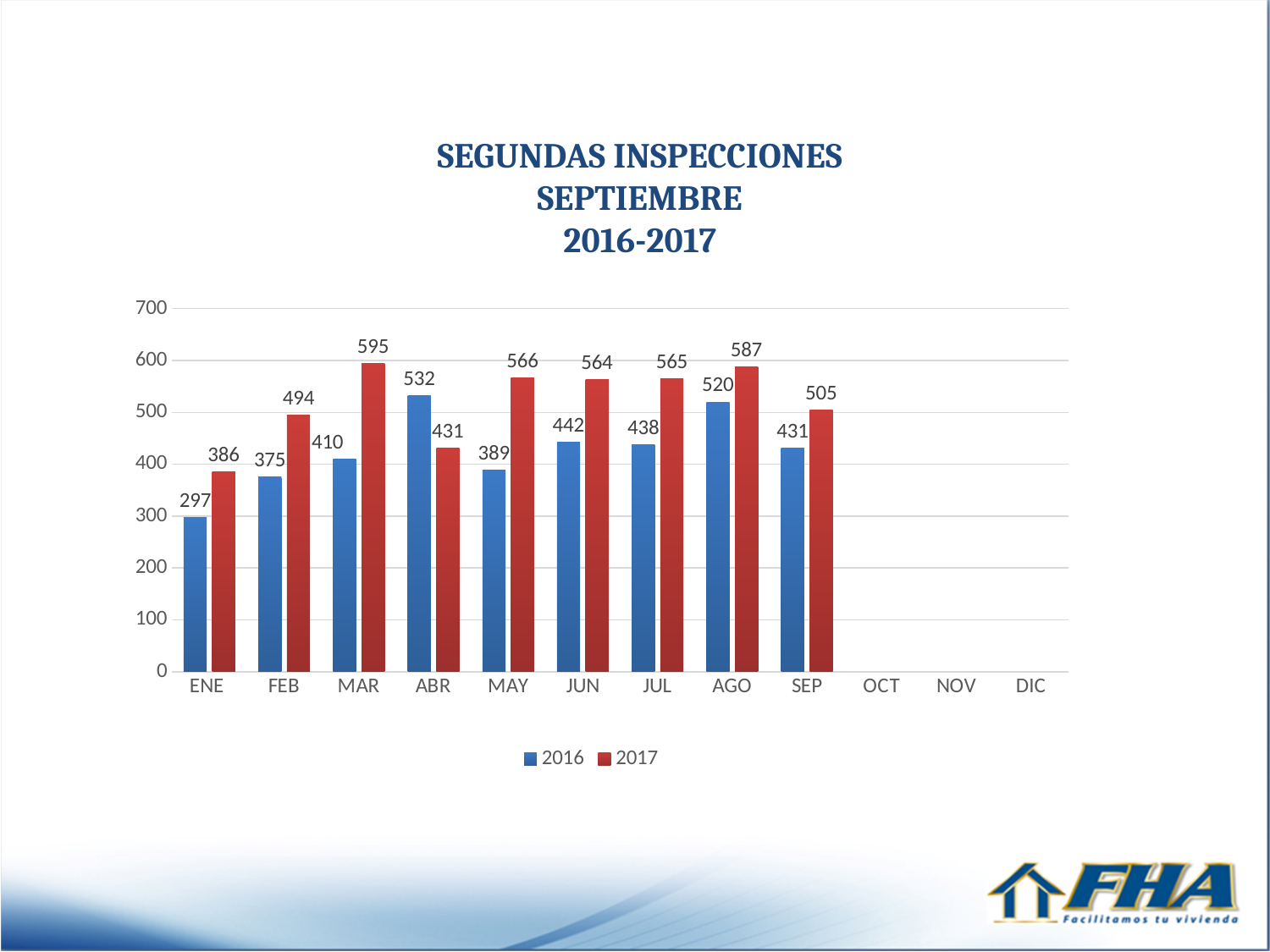
What colour represents the 2017 series? Red What is the value for 2016 in ABR? 532 What is the difference between the 2017 and 2016 values in MAR? 185 What is the value for 2017 in MAR? 595 Which month has the highest value for the 2017 series? MAR How many months have bars plotted on the chart? 9 What is the difference between the 2016 and 2017 values in ABR? 101 How many series does the legend list? 2 What is the value for 2016 in SEP? 431 In AGO, which series has the larger value, 2016 or 2017? 2017 Which month has the lowest value for the 2016 series? ENE What kind of chart is shown on the slide? Bar chart